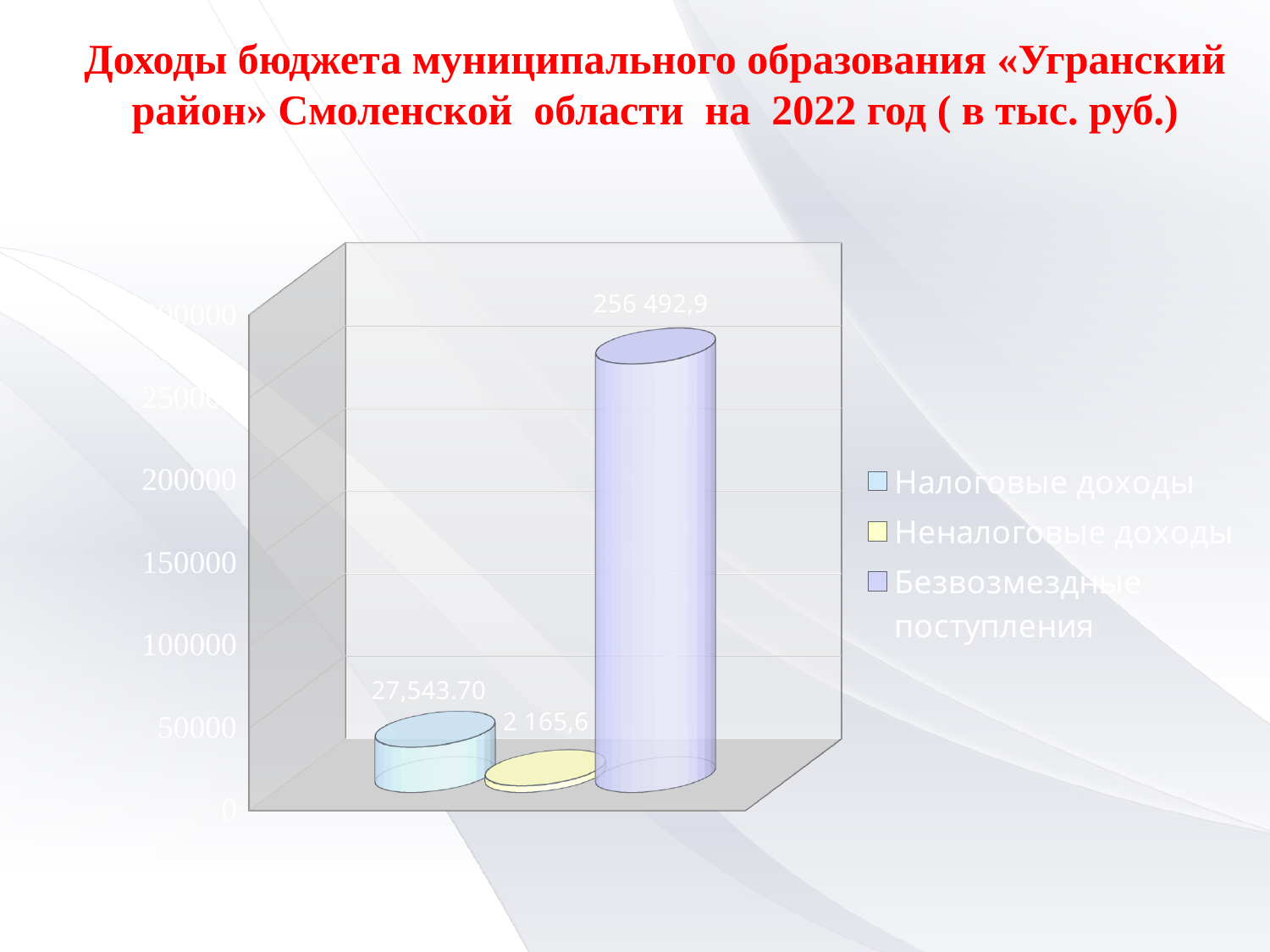
Which category has the lowest value? Неналоговые доходы What is the value for Налоговые доходы? 27,543.70 Is the value for Безвозмездные поступления greater or less than 250000? greater What is the value for Неналоговые доходы? 2 165,6 Which is larger, Налоговые доходы or Неналоговые доходы? Налоговые доходы Is the value for Налоговые доходы greater or less than 50000? less How many series does the legend list? 3 What is the value for Безвозмездные поступления? 256 492,9 What unit is stated in the chart title? тыс. руб. Which category has the highest value? Безвозмездные поступления What is the difference between Безвозмездные поступления and Налоговые доходы? 228949.2 What kind of chart is shown on the slide? Bar chart